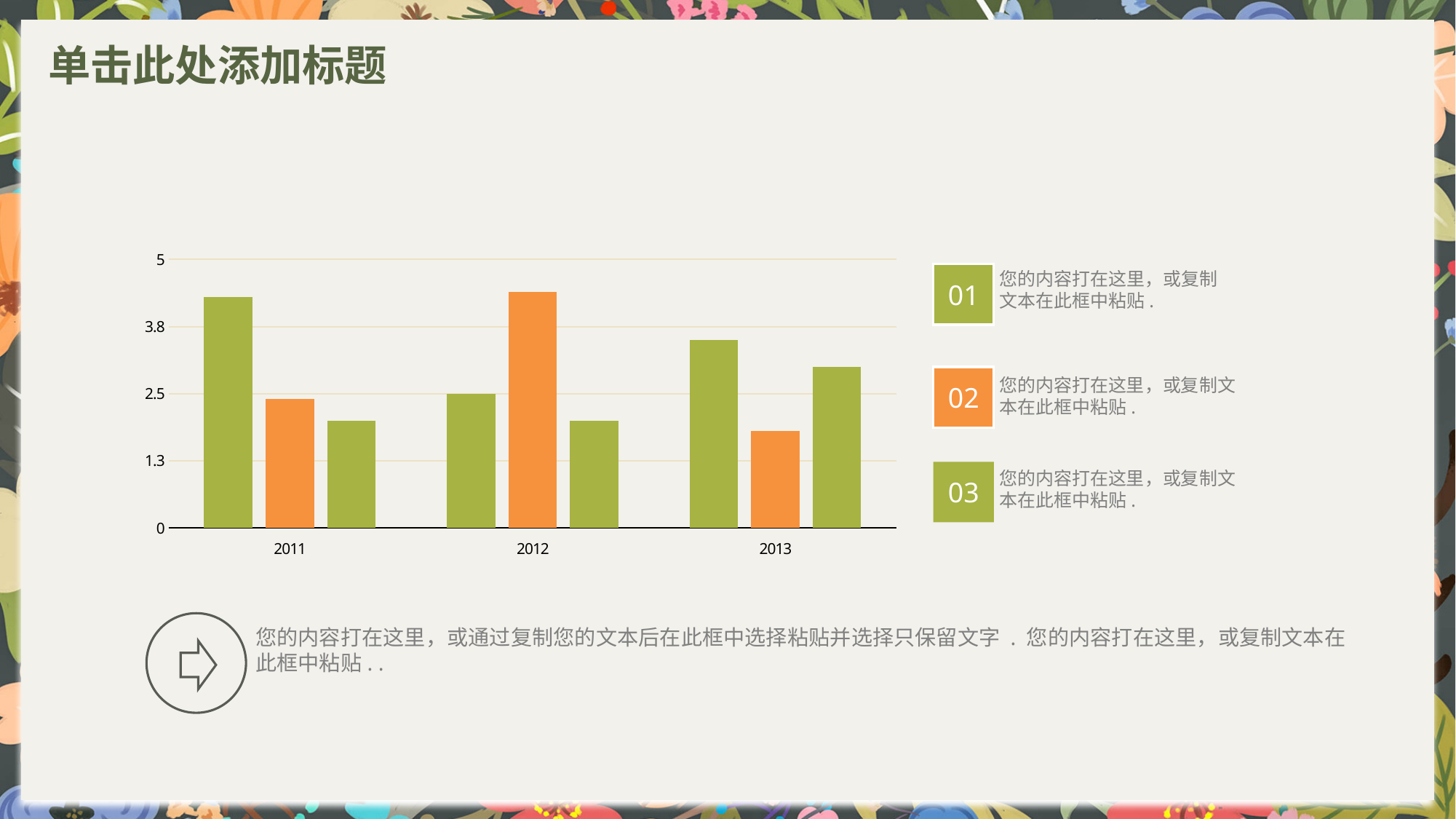
Which is larger: the first (left) bar in 2011 or the first (left) bar in 2012? the first bar in 2011 Is the value of the first (left) bar in the 2013 group greater or less than 3.8? less What kind of chart is shown on the slide? bar chart How many bars are plotted in total on the chart? 9 Is the value of the third (right) bar in the 2013 group greater or less than 2.5? greater Which bar is the shortest within the 2013 group? the middle (orange) bar Is the value of the middle (orange) bar in the 2013 group greater or less than 2.5? less How many categories are shown on the x axis of the chart? 3 What colour is the middle bar in each year group? orange What is the value of the first (left) bar in the 2012 group? 2.5 Which bar is the tallest within the 2011 group? the first (left) bar